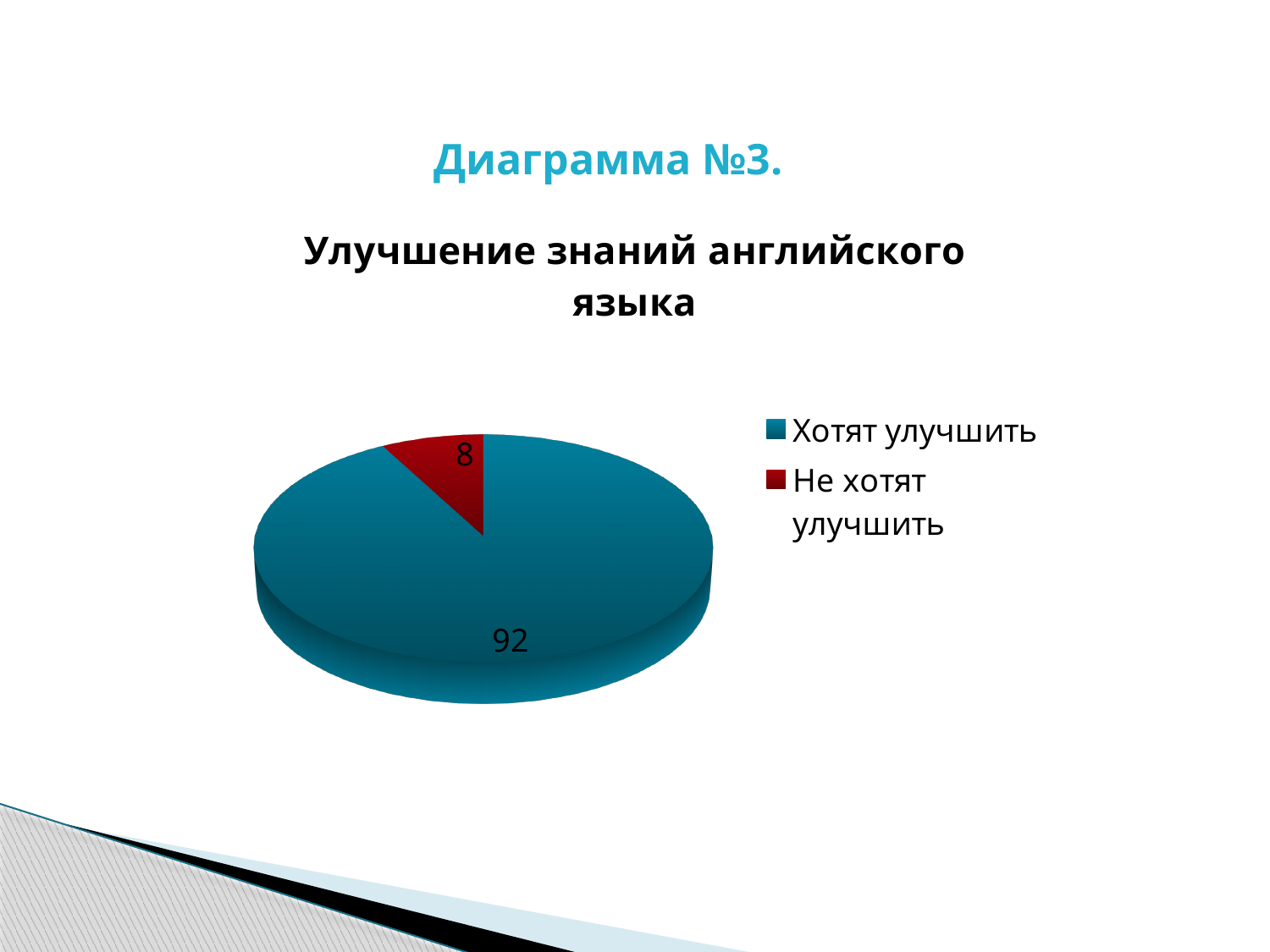
How many slices does the pie chart have? 2 What colour is the slice for "Не хотят улучшить"? dark red How many entries does the legend list? 2 What is the title of the chart? Улучшение знаний английского языка Which is larger, the value for "Хотят улучшить" or for "Не хотят улучшить"? Хотят улучшить Which category has the smallest slice? Не хотят улучшить What is the total of the two slice values? 100 What is the value for "Хотят улучшить"? 92 What kind of chart is shown on the slide? pie chart What is the difference between the values for "Хотят улучшить" and "Не хотят улучшить"? 84 Which category has the largest slice? Хотят улучшить What is the value for "Не хотят улучшить"? 8